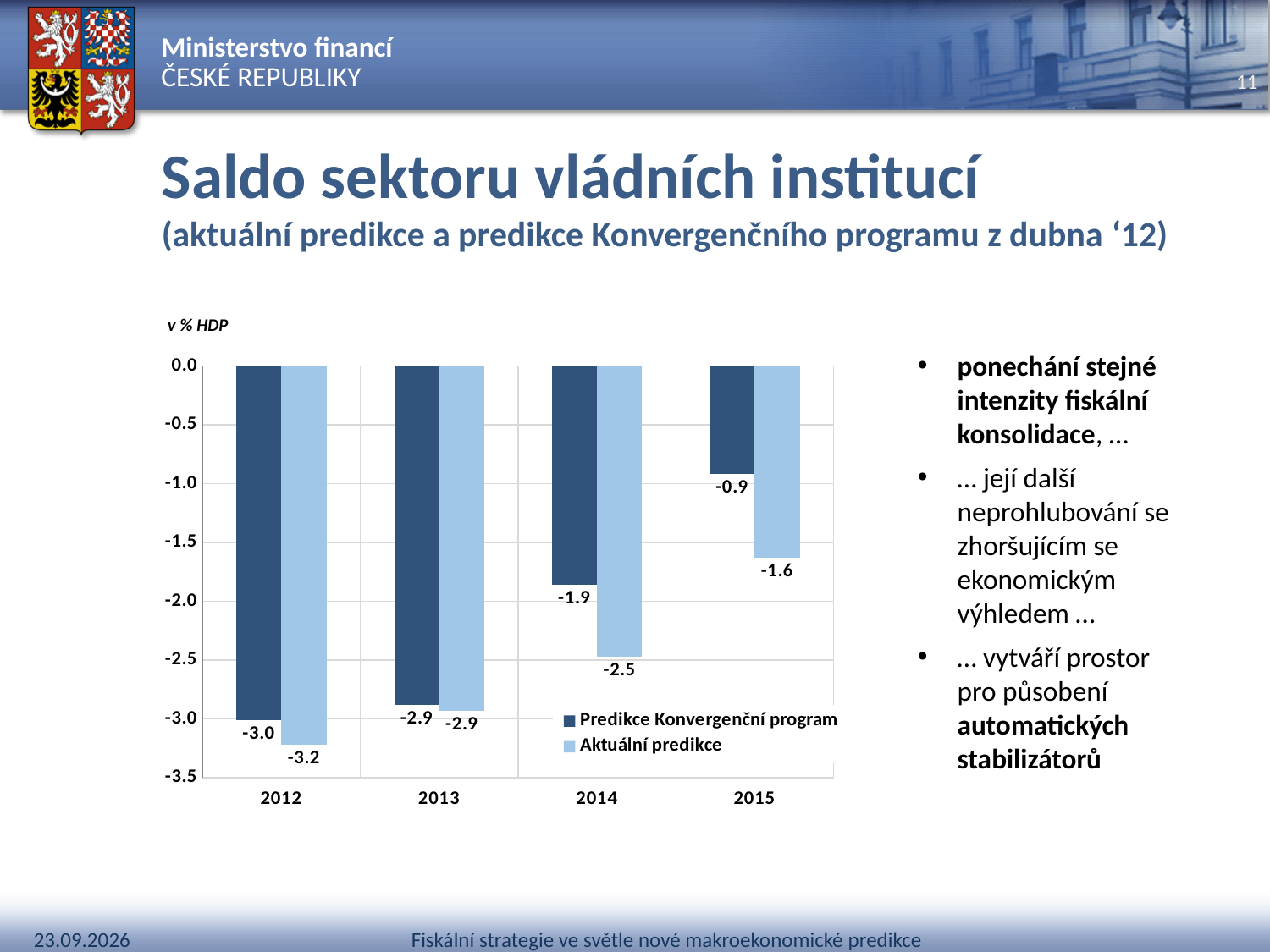
Is the value for Aktuální predikce in 2015 greater or less than -1.5? less How many years are shown on the x axis? 4 What is the difference between Predikce Konvergenční program and Aktuální predikce in 2014? 0.6 What is the value for Aktuální predikce in 2015? -1.6 In which year does the Aktuální predikce series have its lowest value? 2012 What is the value for Predikce Konvergenční program in 2014? -1.9 Which is larger in 2015, Predikce Konvergenční program or Aktuální predikce? Predikce Konvergenční program What is the value for Predikce Konvergenční program in 2013? -2.9 What is the value for Aktuální predikce in 2012? -3.2 How many series does the legend list? 2 Do the values for Predikce Konvergenční program rise or fall from 2012 to 2015? rise In which year does the Predikce Konvergenční program series have its highest value? 2015